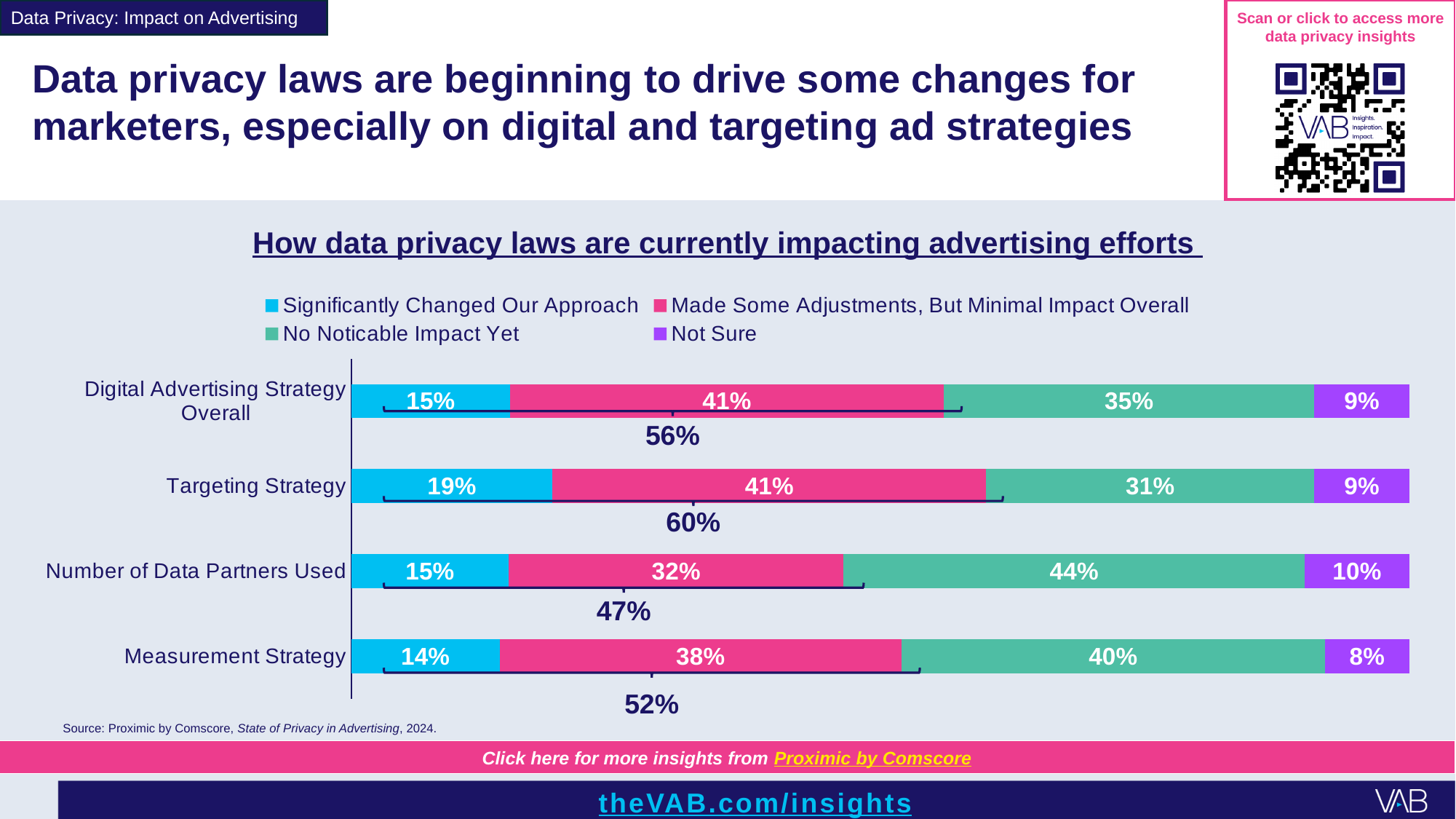
Which is larger: the 'Made Some Adjustments, But Minimal Impact Overall' value for Measurement Strategy or for Number of Data Partners Used? Measurement Strategy What is the difference between the 'No Noticable Impact Yet' values for Number of Data Partners Used and Targeting Strategy? 13% What combined percentage is shown by the bracket under the Targeting Strategy bar? 60% What is the 'Not Sure' value for Measurement Strategy? 8% Which category has the lowest 'No Noticable Impact Yet' value? Targeting Strategy What percentage of respondents said data privacy laws 'Significantly Changed Our Approach' for Targeting Strategy? 19% What type of chart is shown on the slide? Stacked bar chart How many series does the legend list? 4 How many categories are shown on the chart? 4 Which category has the highest 'Significantly Changed Our Approach' value? Targeting Strategy What is the 'No Noticable Impact Yet' value for Number of Data Partners Used? 44% What is the 'Made Some Adjustments, But Minimal Impact Overall' value for Digital Advertising Strategy Overall? 41%